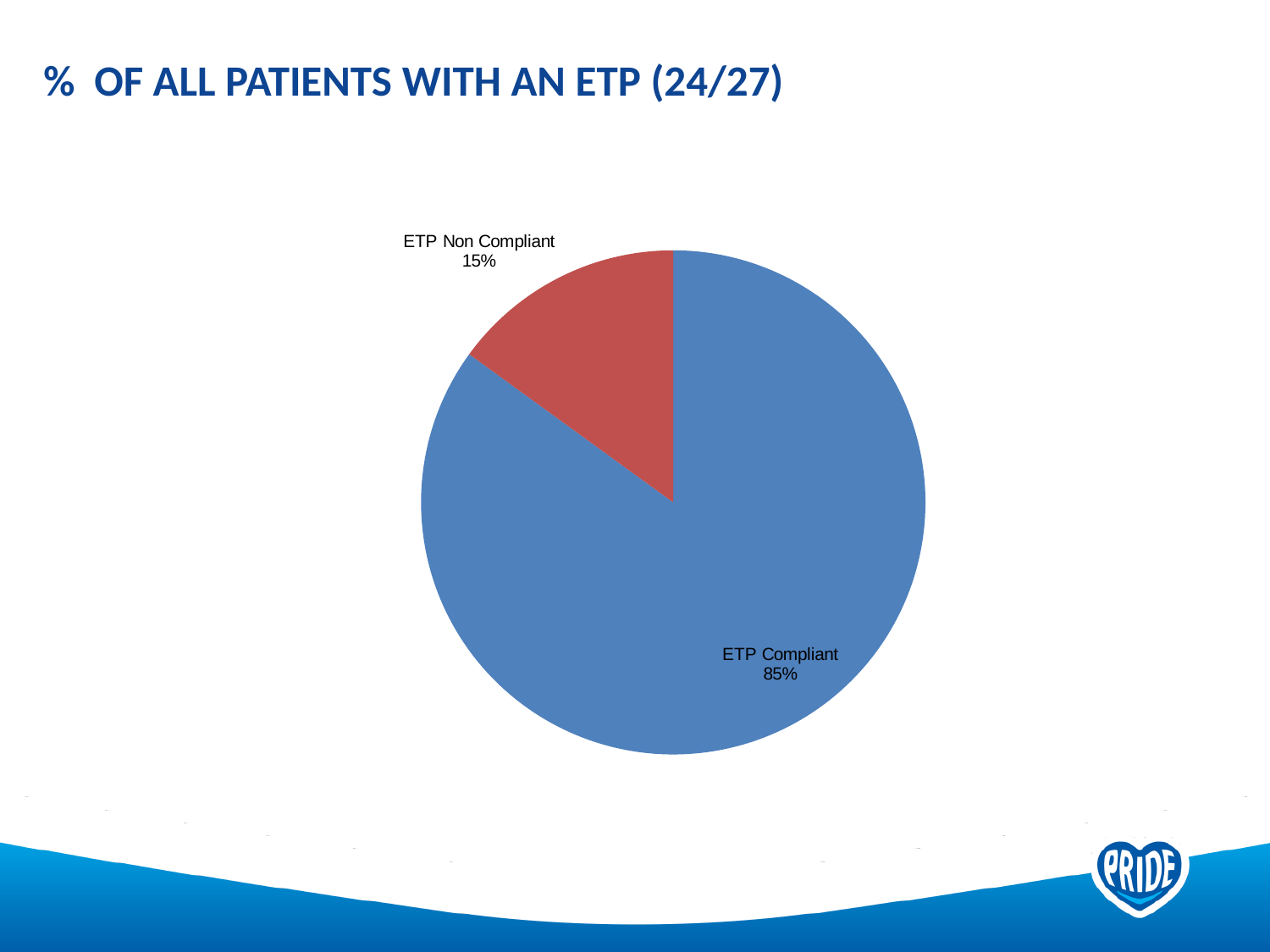
Which is larger, the ETP Compliant slice or the ETP Non Compliant slice? ETP Compliant How many slices does the pie chart have? 2 What colour is the ETP Non Compliant slice? red What type of chart is shown on the slide? pie chart What is the title of the chart? % OF ALL PATIENTS WITH AN ETP (24/27) Which slice of the pie is the smallest? ETP Non Compliant What percentage of patients are ETP Compliant? 85% What is the difference in percentage points between ETP Compliant and ETP Non Compliant? 70 What share of the pie does the ETP Non Compliant slice represent? 15% Which slice of the pie is the largest? ETP Compliant What percentage of patients are ETP Non Compliant? 15%